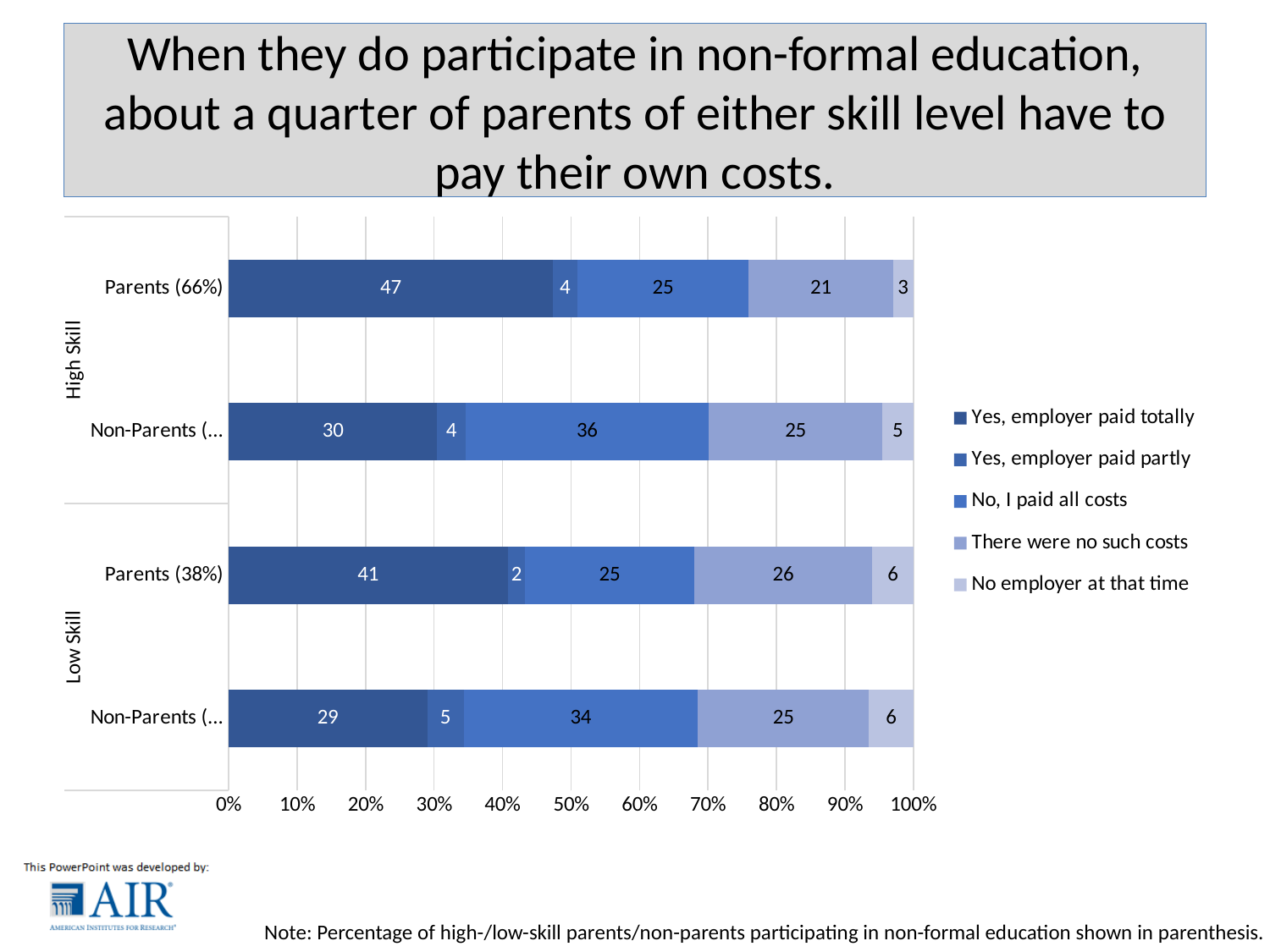
What is the total of the stacked bar for Low Skill Non-Parents? 99 What is the value for 'There were no such costs' for Low Skill Parents (38%)? 26 Which category has the highest value for 'Yes, employer paid totally'? High Skill Parents (66%) What kind of chart is shown on the slide? Stacked bar chart How many bars (categories) are plotted in the chart? 4 What is the difference between the 'Yes, employer paid totally' values for High Skill Parents (66%) and Low Skill Parents (38%)? 6 How many series does the legend list? 5 What is the value for 'No, I paid all costs' for High Skill Non-Parents? 36 What is the value for 'Yes, employer paid totally' for High Skill Parents (66%)? 47 What is the value for 'No employer at that time' for Low Skill Non-Parents? 6 Which is larger: the 'No, I paid all costs' value for High Skill Non-Parents or for Low Skill Non-Parents? High Skill Non-Parents Which category has the lowest value for 'Yes, employer paid partly'? Low Skill Parents (38%)